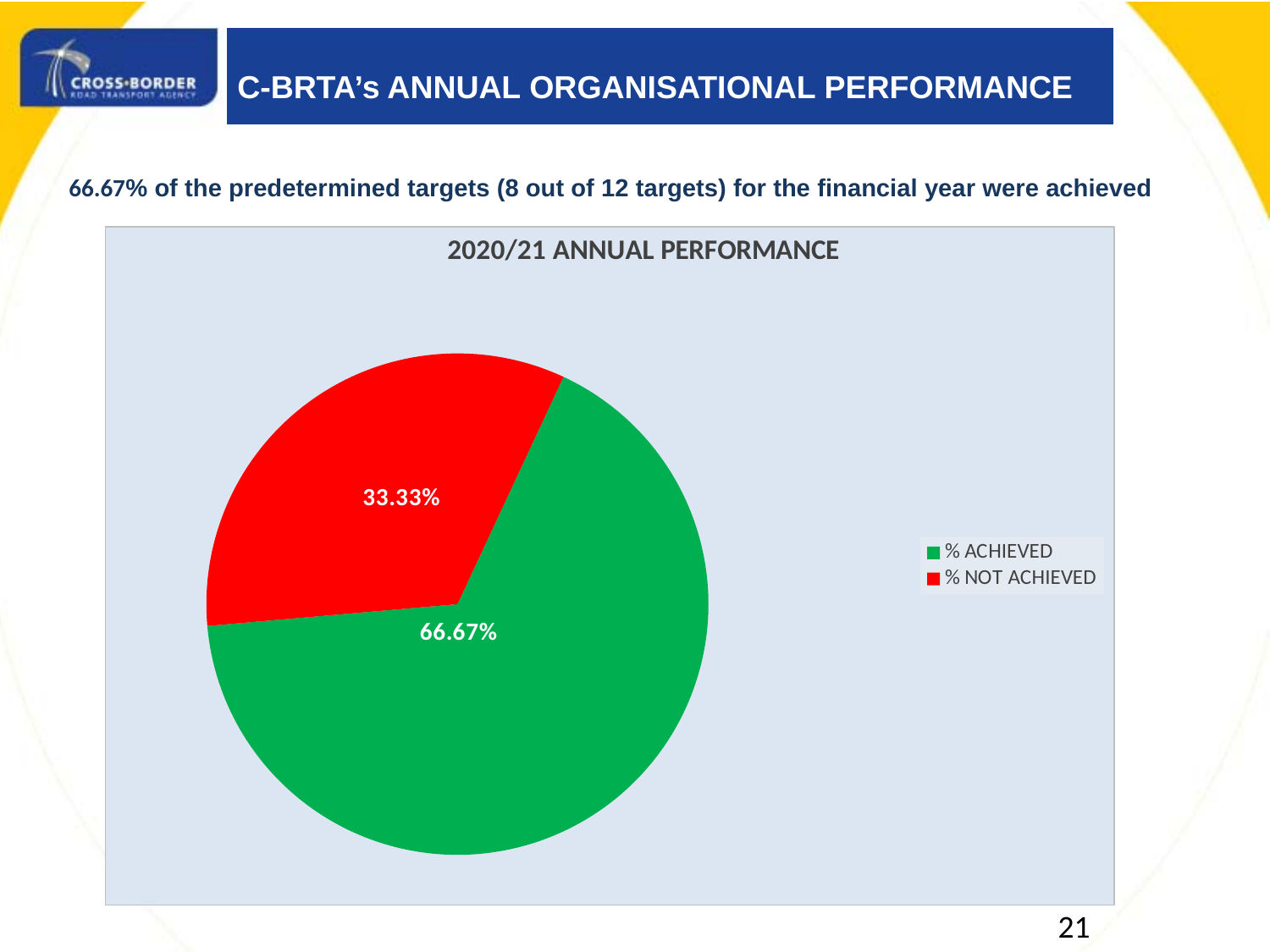
Which is larger, % ACHIEVED or % NOT ACHIEVED? % ACHIEVED What colour is the % NOT ACHIEVED slice? red What share of the pie does the % ACHIEVED slice represent? 66.67% Which slice is the largest? % ACHIEVED How many entries does the legend list? 2 What is the value for % ACHIEVED? 66.67% What is the value for % NOT ACHIEVED? 33.33% What is the difference between the % ACHIEVED and % NOT ACHIEVED slices? 33.34% Which slice is the smallest? % NOT ACHIEVED What is the title of the chart? 2020/21 ANNUAL PERFORMANCE What kind of chart is shown on the slide? pie chart How many slices does the pie chart have? 2